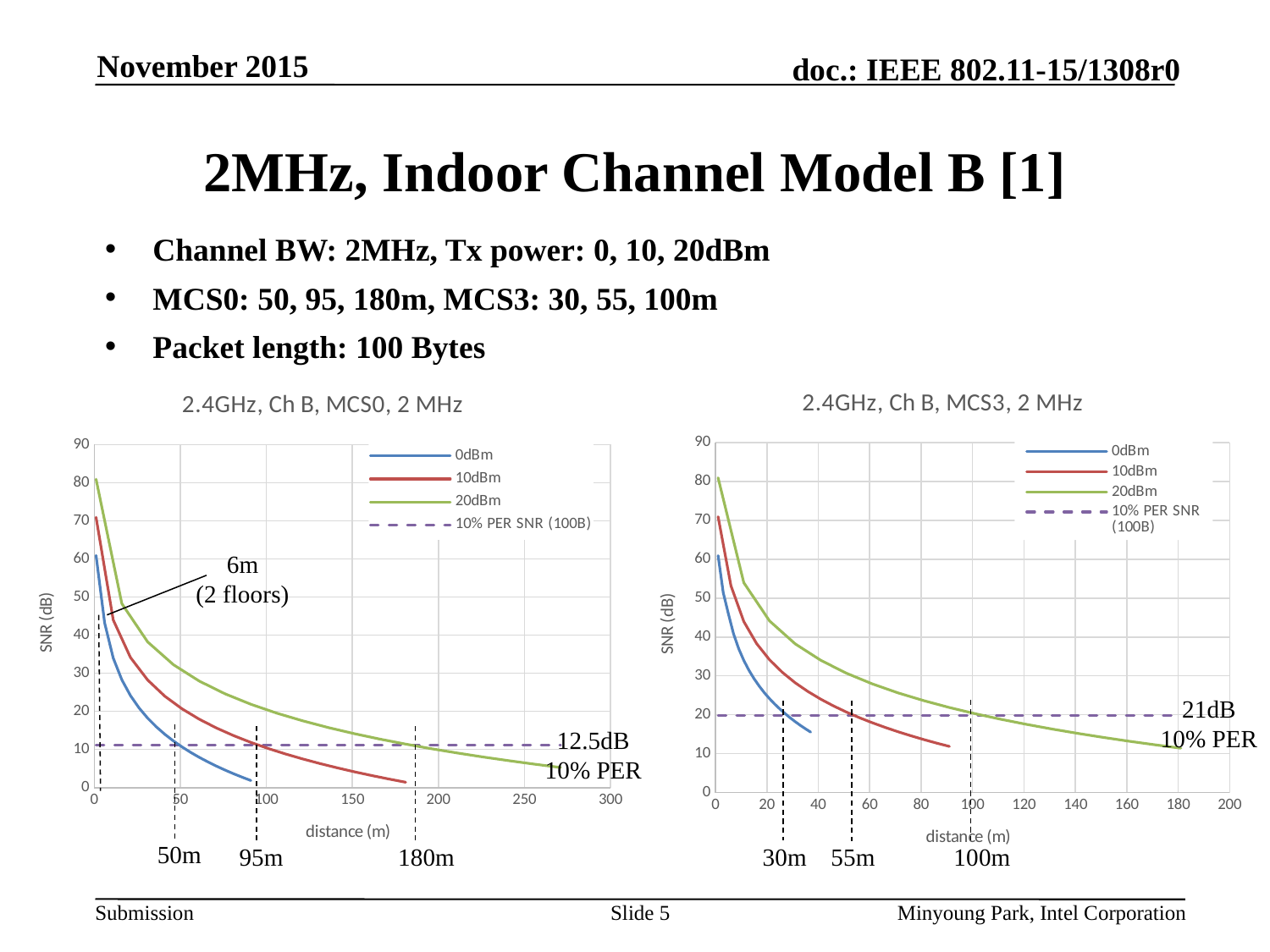
In the left chart (MCS0), is the SNR of the 0dBm series at distance 0 greater or less than 50 dB? greater In the left chart (MCS0), does SNR rise or fall as distance increases? fall In the right chart (MCS3), at what distance does the 10dBm curve cross the 10% PER SNR line, according to the annotation? 55m In the right chart (MCS3), is the 10% PER SNR line greater or less than 30 dB? less In the left chart (MCS0), at what distance does the 20dBm curve cross the 10% PER SNR line, according to the annotation? 180m What kind of chart is the left chart titled '2.4GHz, Ch B, MCS0, 2 MHz'? line chart In the right chart (MCS3), at what distance does the 0dBm curve cross the 10% PER SNR line, according to the annotation? 30m What is the x-axis label of the right chart '2.4GHz, Ch B, MCS3, 2 MHz'? distance (m) How many series does the legend of the right chart '2.4GHz, Ch B, MCS3, 2 MHz' list? 4 In the left chart (MCS0), what SNR value is annotated for the 10% PER line? 12.5dB In the right chart (MCS3), what SNR value is annotated for the 10% PER line? 21dB In the left chart (MCS0), at a distance of 50 m, which series has the higher SNR: 0dBm or 20dBm? 20dBm